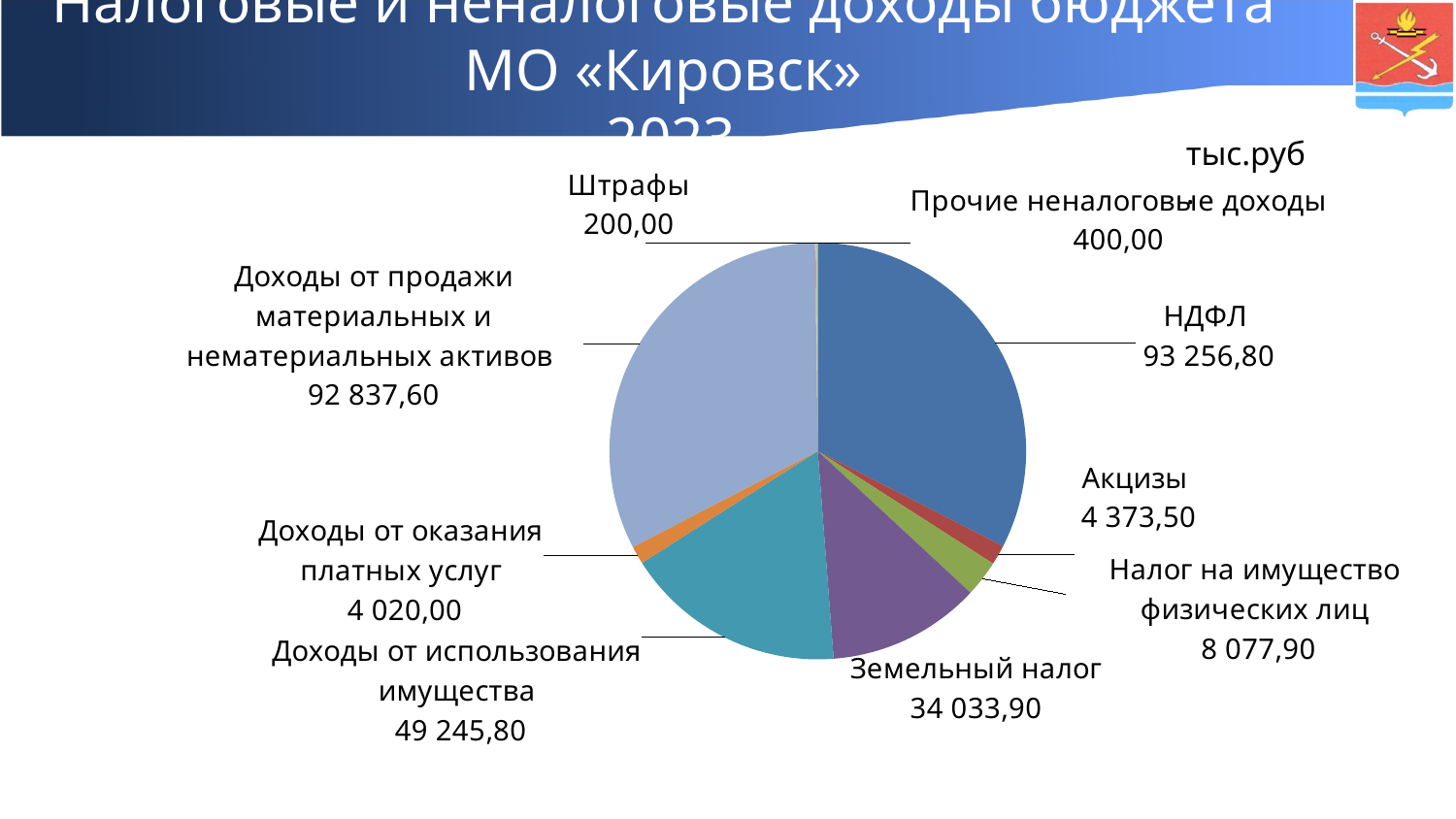
What is the value for Акцизы? 4 373,50 What is the value for Налог на имущество физических лиц? 8 077,90 What is the value for НДФЛ? 93 256,80 What unit of measurement is indicated for the chart values? тыс.руб What is the difference between Земельный налог and Налог на имущество физических лиц? 25 956,00 What kind of chart is shown on the slide? Pie chart How many categories are shown in the pie chart? 9 Which category has the smallest value? Штрафы Which is larger: Доходы от оказания платных услуг or Акцизы? Акцизы Which category has the largest value? НДФЛ What is the value for Доходы от использования имущества? 49 245,80 What is the value for Земельный налог? 34 033,90